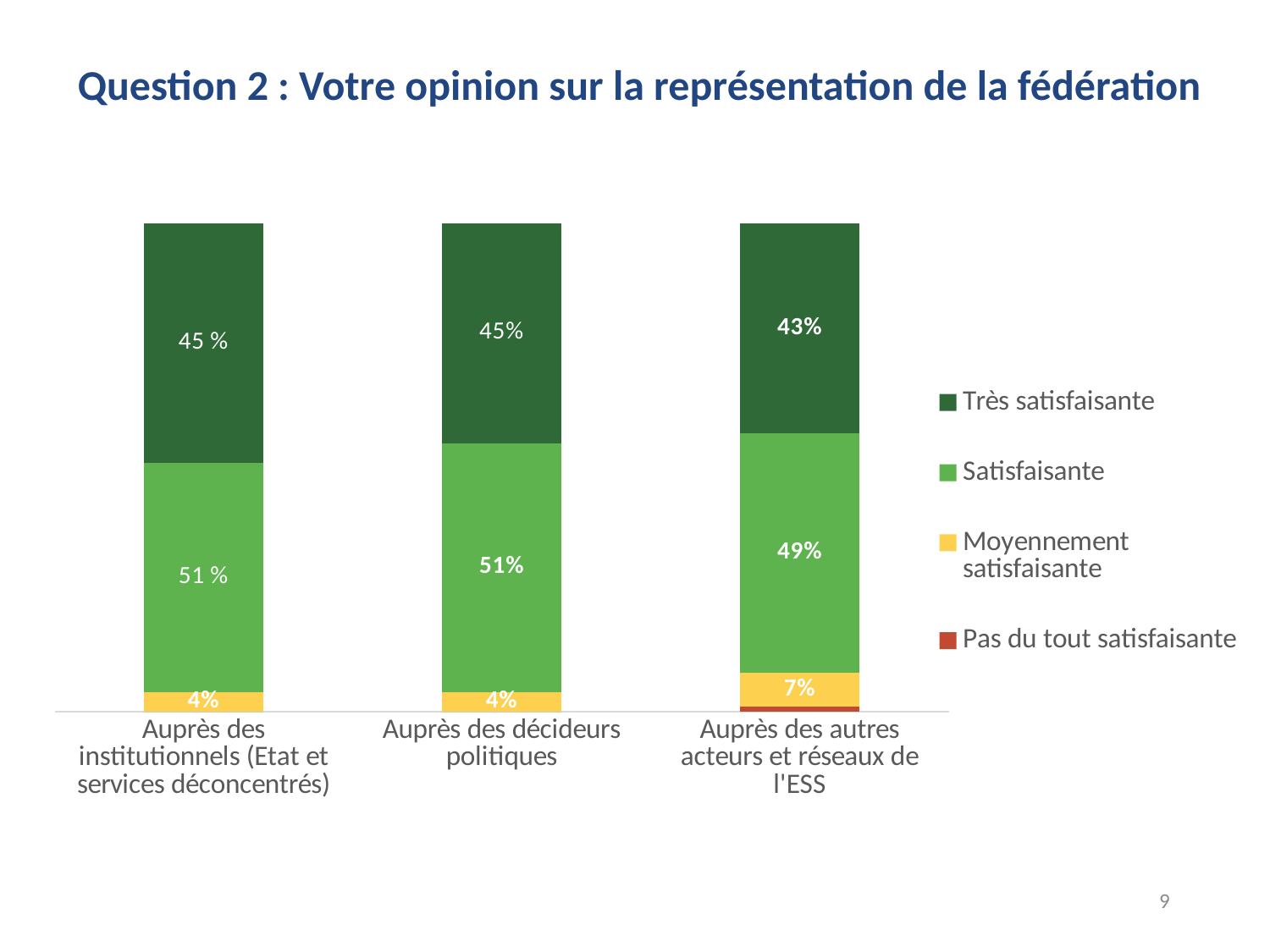
What is the value for 'Satisfaisante' for 'Auprès des décideurs politiques'? 51% Which legend entry is shown in red? Pas du tout satisfaisante What is the value for 'Moyennement satisfaisante' for 'Auprès des autres acteurs et réseaux de l'ESS'? 7% Which category has the lowest value for 'Très satisfaisante'? Auprès des autres acteurs et réseaux de l'ESS What kind of chart is shown on the slide? Stacked bar chart Which category has the highest value for 'Moyennement satisfaisante'? Auprès des autres acteurs et réseaux de l'ESS What is the value for 'Très satisfaisante' for 'Auprès des autres acteurs et réseaux de l'ESS'? 43% What is the difference between the 'Satisfaisante' values for 'Auprès des décideurs politiques' and 'Auprès des autres acteurs et réseaux de l'ESS'? 2% How many series does the legend list? 4 Which is larger for 'Auprès des décideurs politiques': 'Très satisfaisante' or 'Satisfaisante'? Satisfaisante What is the value for 'Très satisfaisante' for 'Auprès des institutionnels (Etat et services déconcentrés)'? 45 % How many categories are shown on the x axis? 3